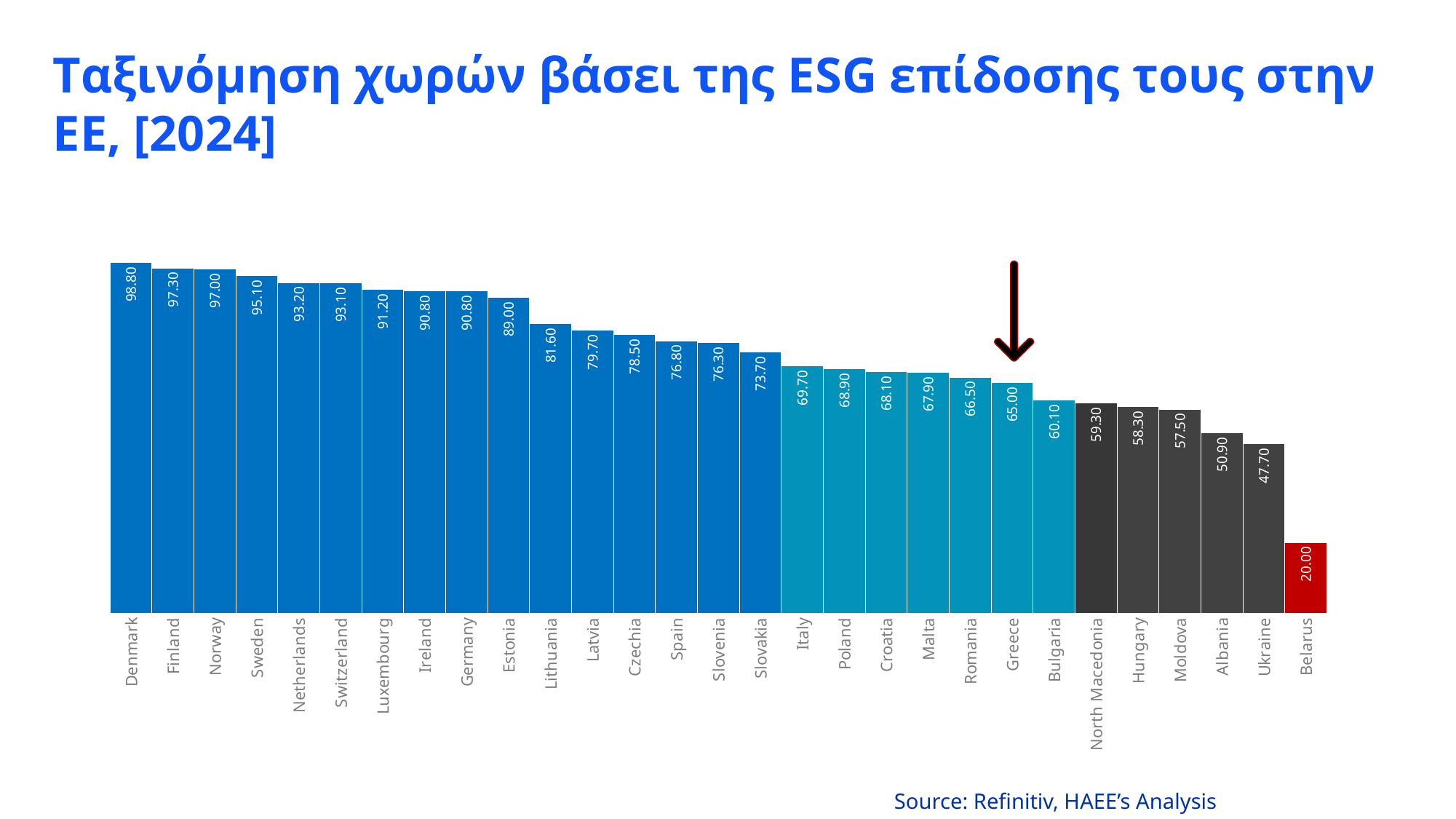
How many countries are shown in the chart? 29 Which country's bar is marked with an arrow above it? Greece Which has a larger value, Italy or Bulgaria? Italy Which country has the highest value? Denmark What is the value for Belarus? 20.00 What kind of chart is shown on the slide? Bar chart Which country has the lowest value? Belarus Do the values rise or fall from left to right along the x axis? Fall What is the value for Denmark? 98.80 What is the difference between the values for Denmark and Greece? 33.80 What is the value for Greece? 65.00 What is the difference between the values for Ukraine and Belarus? 27.70